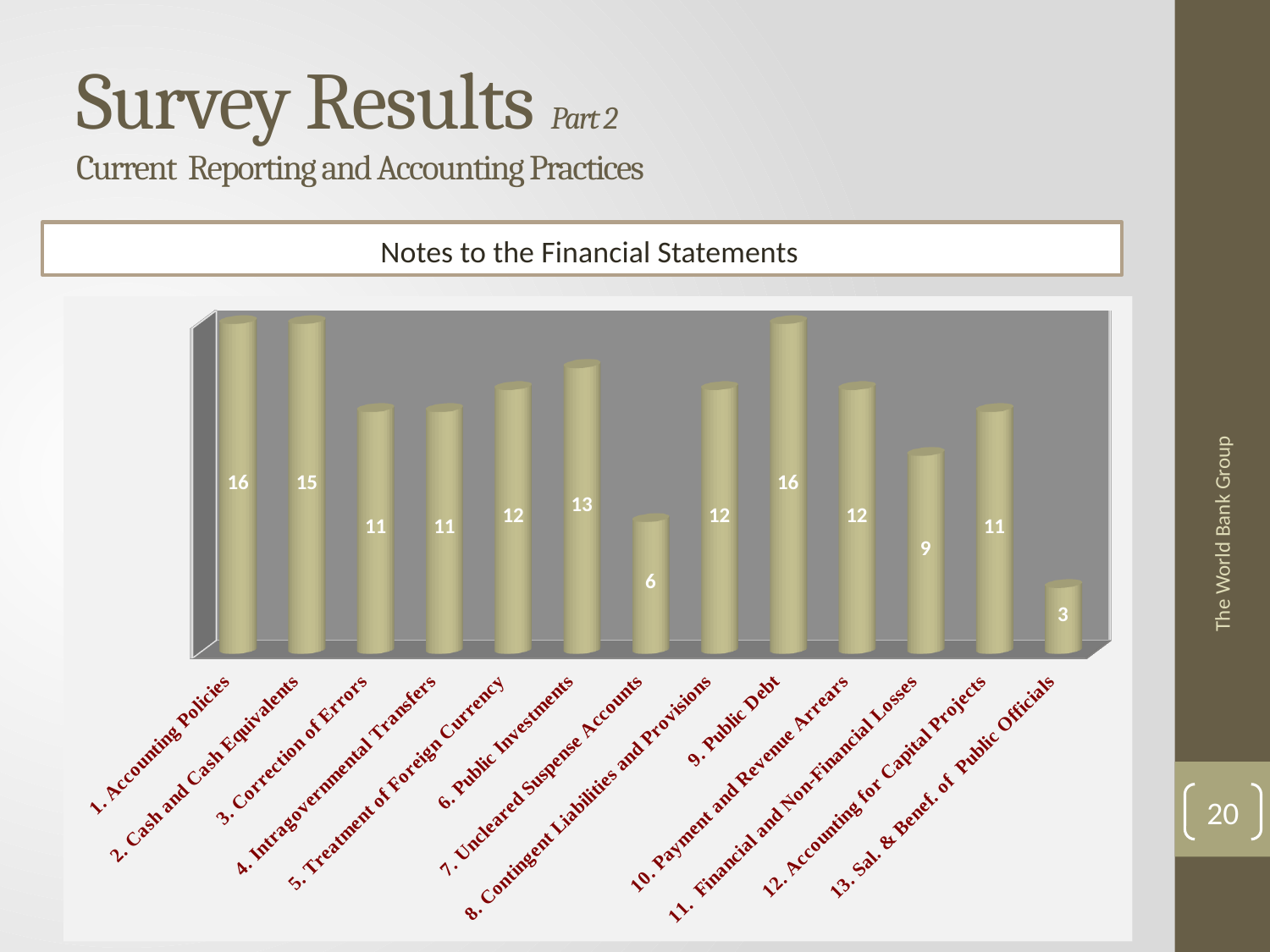
Which category has the lowest value? 13. Sal. & Benef. of Public Officials What is the value for 6. Public Investments? 13 What kind of chart is shown on the slide? Bar chart Which is larger, the value for 6. Public Investments or the value for 11. Financial and Non-Financial Losses? 6. Public Investments What is the value for 7. Uncleared Suspense Accounts? 6 How many categories are shown in the chart? 13 Which is larger, the value for 7. Uncleared Suspense Accounts or the value for 8. Contingent Liabilities and Provisions? 8. Contingent Liabilities and Provisions What is the value for 1. Accounting Policies? 16 What is the title of the chart? Notes to the Financial Statements What is the difference between the values for 9. Public Debt and 13. Sal. & Benef. of Public Officials? 13 What is the difference between the values for 2. Cash and Cash Equivalents and 3. Correction of Errors? 4 What is the value for 11. Financial and Non-Financial Losses? 9